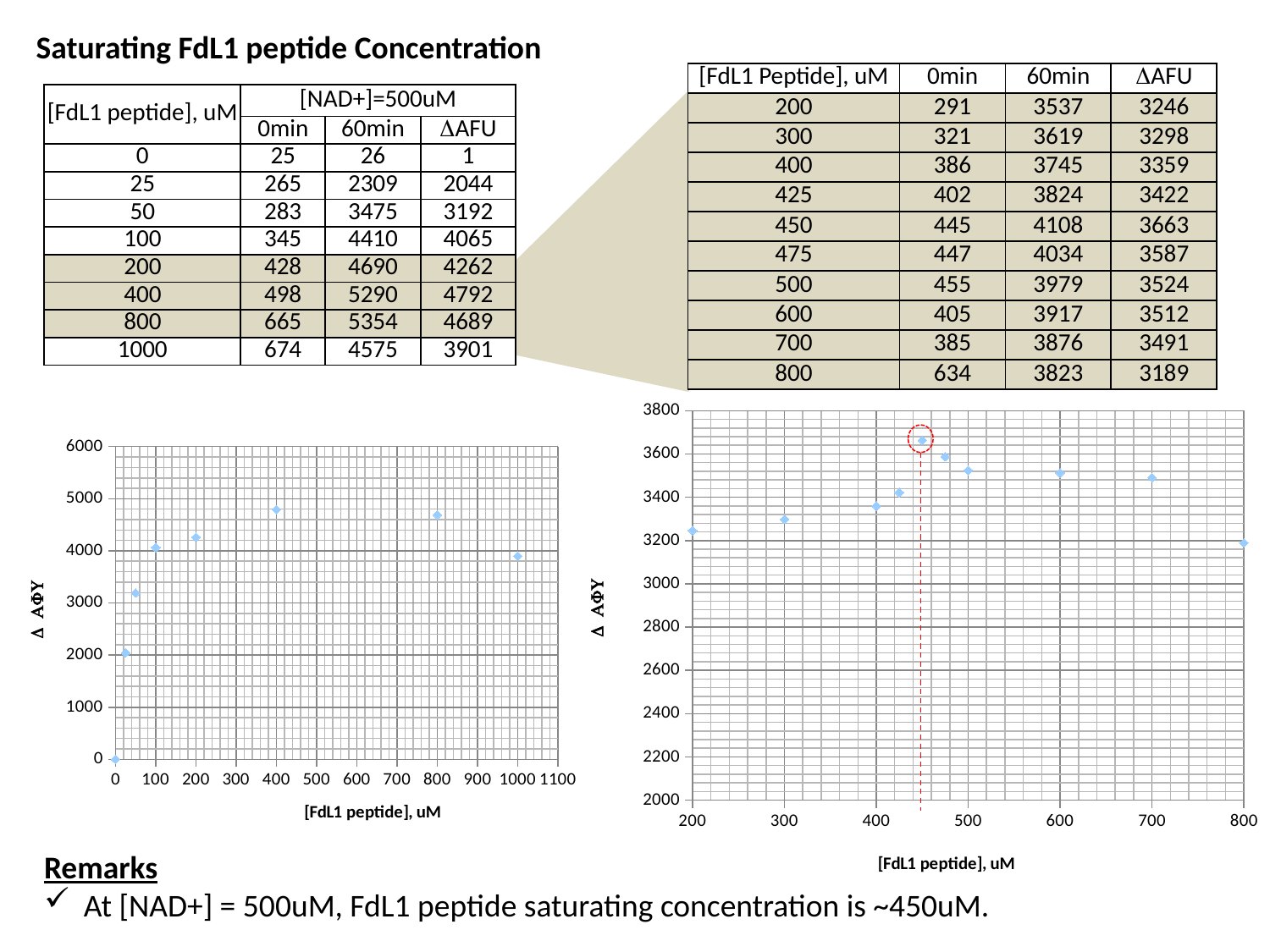
In the chart on the right, at which [FdL1 peptide] concentration is the ΔAFU value highest? 450 In the chart on the left, is the ΔAFU value at 1000 uM greater or less than 4000? less How many data points are plotted in the chart on the left of the slide? 8 In the chart on the left, at which [FdL1 peptide] concentration is the ΔAFU value lowest? 0 In the chart on the left, which has the larger ΔAFU value: 400 uM or 1000 uM? 400 uM How many data points are plotted in the chart on the right of the slide? 10 What is the x-axis title of the chart on the right? [FdL1 peptide], uM What kind of chart is the chart on the left of the slide? scatter chart In the chart on the right, what is the ΔAFU value at 450 uM, as given in the table above it? 3663 In the chart on the right, is the ΔAFU value at 450 uM greater or less than 3600? greater In the chart on the right, is the ΔAFU value at 800 uM greater or less than 3400? less In the chart on the right, how does ΔAFU change as [FdL1 peptide] increases from 450 uM to 800 uM? it falls